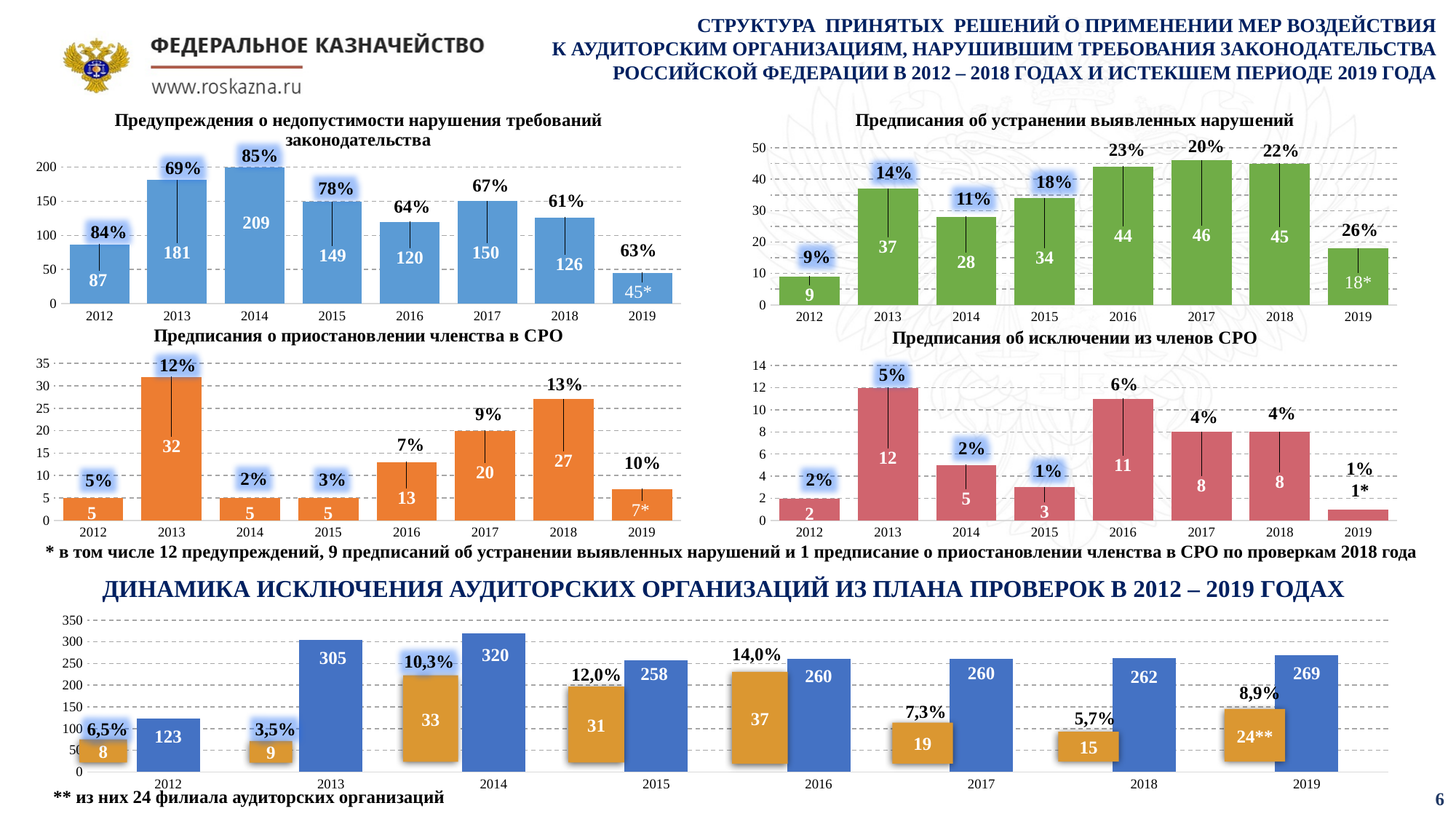
In the chart "Предписания об исключении из членов СРО", how many years are shown on the x axis? 8 In the chart "Предписания об исключении из членов СРО", what is the value for 2016? 11 In the chart "Предписания о приостановлении членства в СРО", what is the value for 2018? 27 In the bottom chart "ДИНАМИКА ИСКЛЮЧЕНИЯ АУДИТОРСКИХ ОРГАНИЗАЦИЙ ИЗ ПЛАНА ПРОВЕРОК В 2012 – 2019 ГОДАХ", what is the value of the blue bar for 2014? 320 In the chart "Предписания об устранении выявленных нарушений", which year has the highest value? 2017 In the chart "Предписания об устранении выявленных нарушений", what percentage is shown above the 2016 bar? 23% In the chart "Предупреждения о недопустимости нарушения требований законодательства", what is the value for 2014? 209 What type of chart is the chart "Предписания о приостановлении членства в СРО"? Bar chart In the chart "Предписания об устранении выявленных нарушений", what is the difference between the values for 2013 and 2012? 28 In the chart "Предупреждения о недопустимости нарушения требований законодательства", which year has the lowest value? 2019 In the chart "Предписания о приостановлении членства в СРО", which is larger, the value for 2013 or the value for 2017? 2013 In the bottom chart "ДИНАМИКА ИСКЛЮЧЕНИЯ АУДИТОРСКИХ ОРГАНИЗАЦИЙ ИЗ ПЛАНА ПРОВЕРОК В 2012 – 2019 ГОДАХ", what percentage is shown for 2016? 14,0%